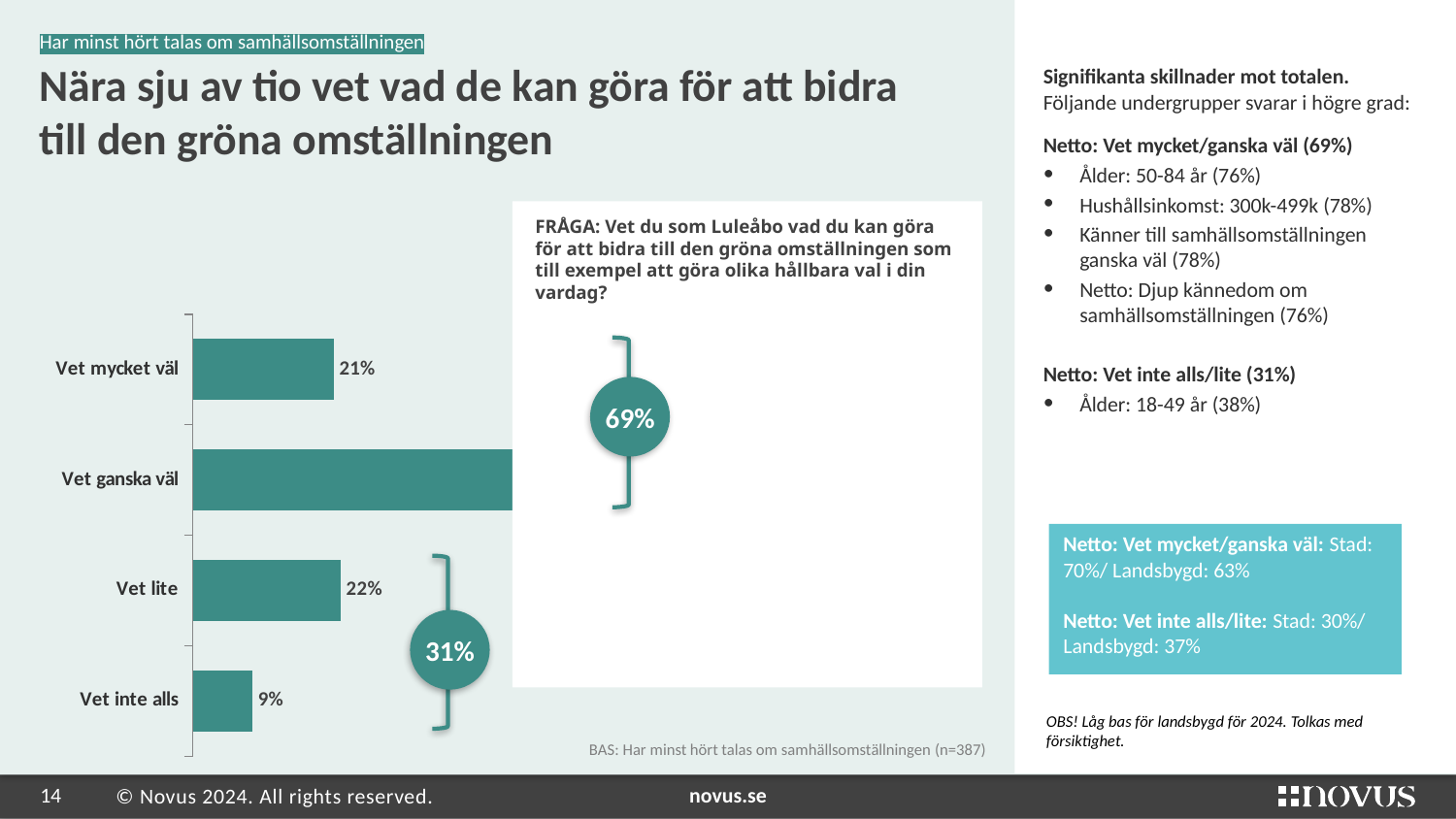
What is the netto value shown for "Vet inte alls/lite" in the chart? 31% Which is larger: the value for "Vet mycket väl" or the value for "Vet inte alls"? Vet mycket väl Which response category has the lowest percentage in the chart? Vet inte alls What is the difference in percentage points between the two netto values, 69% and 31%? 38 What percentage of respondents answered "Vet lite"? 22% Which response category has the longest bar in the chart? Vet ganska väl What is the difference in percentage points between "Vet lite" and "Vet inte alls"? 13 What percentage of respondents answered "Vet mycket väl"? 21% What type of chart is shown on the slide? Bar chart What percentage of respondents answered "Vet inte alls"? 9% How many response categories are shown in the bar chart? 4 What is the netto value shown for "Vet mycket/ganska väl" in the chart? 69%